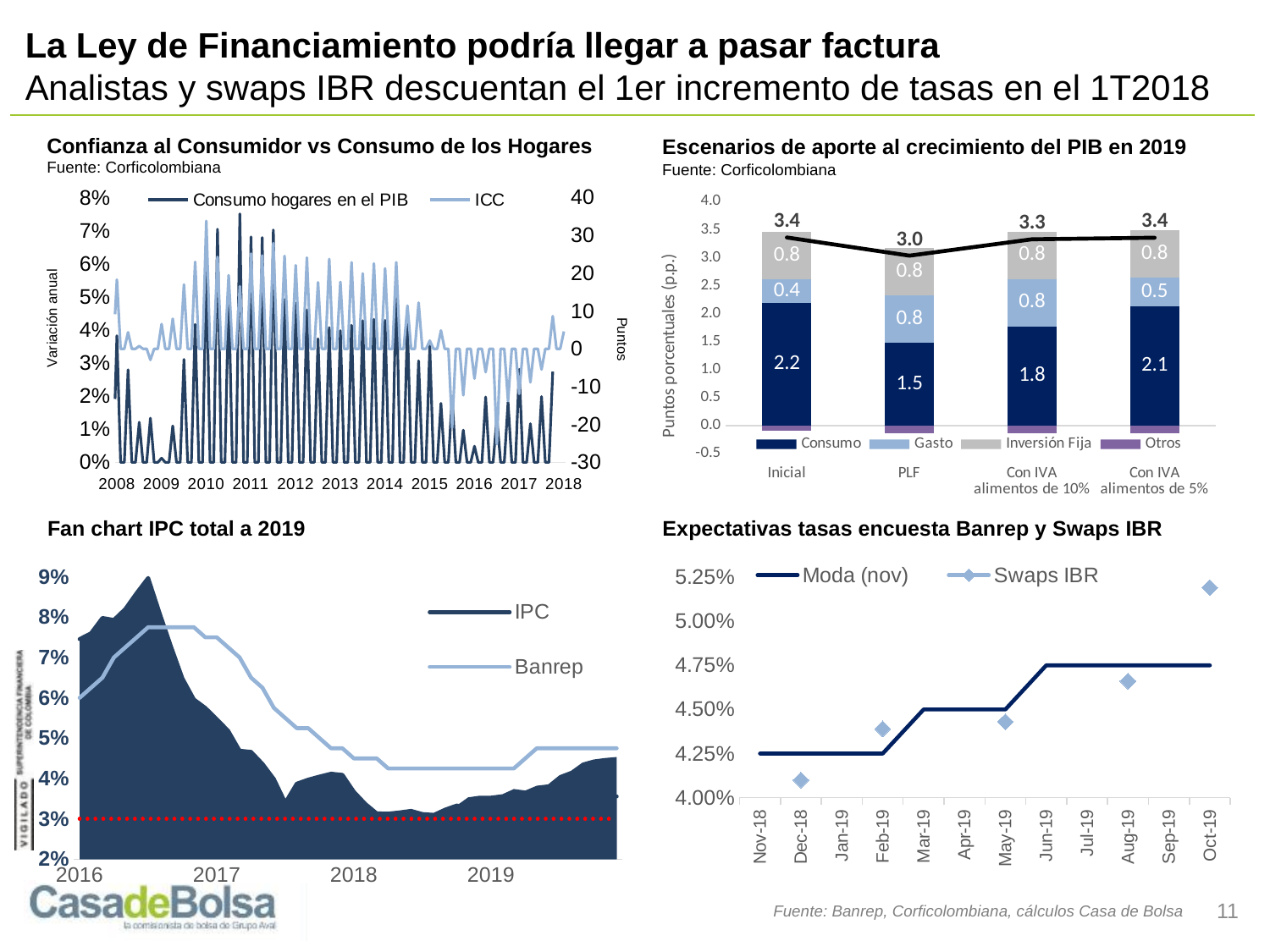
In the chart 'Escenarios de aporte al crecimiento del PIB en 2019', what is the Gasto value for 'Con IVA alimentos de 5%'? 0.5 In the chart 'Expectativas tasas encuesta Banrep y Swaps IBR', what is the Moda (nov) value for Jun-19? 4.75% What kind of chart is 'Escenarios de aporte al crecimiento del PIB en 2019'? Stacked bar chart with a line In the chart 'Escenarios de aporte al crecimiento del PIB en 2019', how many series does the legend list? 4 In the chart 'Confianza al Consumidor vs Consumo de los Hogares', how many series does the legend list? 2 In the chart 'Escenarios de aporte al crecimiento del PIB en 2019', which scenario has the lowest Consumo value? PLF In the chart 'Escenarios de aporte al crecimiento del PIB en 2019', what is the difference between the Consumo values for Inicial and PLF? 0.7 In the chart 'Escenarios de aporte al crecimiento del PIB en 2019', how many scenarios are shown on the x axis? 4 In the chart 'Escenarios de aporte al crecimiento del PIB en 2019', what is the total for the PLF scenario? 3.0 In the chart 'Escenarios de aporte al crecimiento del PIB en 2019', is the Gasto value larger for PLF or for Inicial? PLF In the chart 'Escenarios de aporte al crecimiento del PIB en 2019', what is the Consumo value for the Inicial scenario? 2.2 In the chart 'Expectativas tasas encuesta Banrep y Swaps IBR', is the Swaps IBR value for Oct-19 greater or less than 5.00%? greater